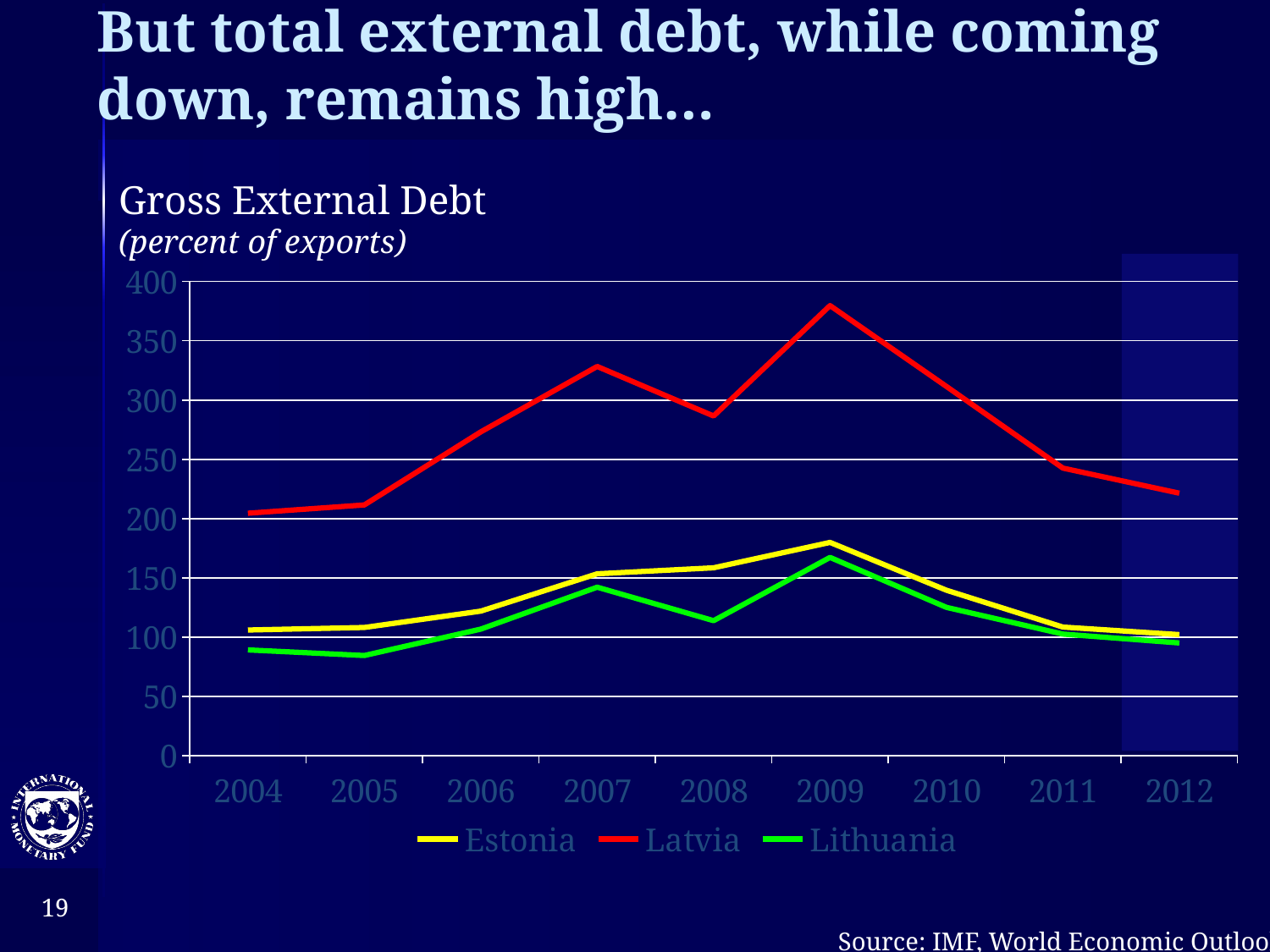
How many years are shown on the x axis? 9 Is the value for Lithuania in 2008 greater or less than 150? less Which country has the higher value in 2009, Latvia or Estonia? Latvia In which year does Latvia's gross external debt reach its highest point? 2009 What is the title of the chart? Gross External Debt Is the value for Latvia in 2009 greater or less than 350? greater Is the value for Latvia in 2004 greater or less than 250? less Which country has the lowest value in 2004? Lithuania Does Latvia's line rise or fall from 2009 to 2012? fall How many series does the legend list? 3 What kind of chart is shown on the slide? line chart